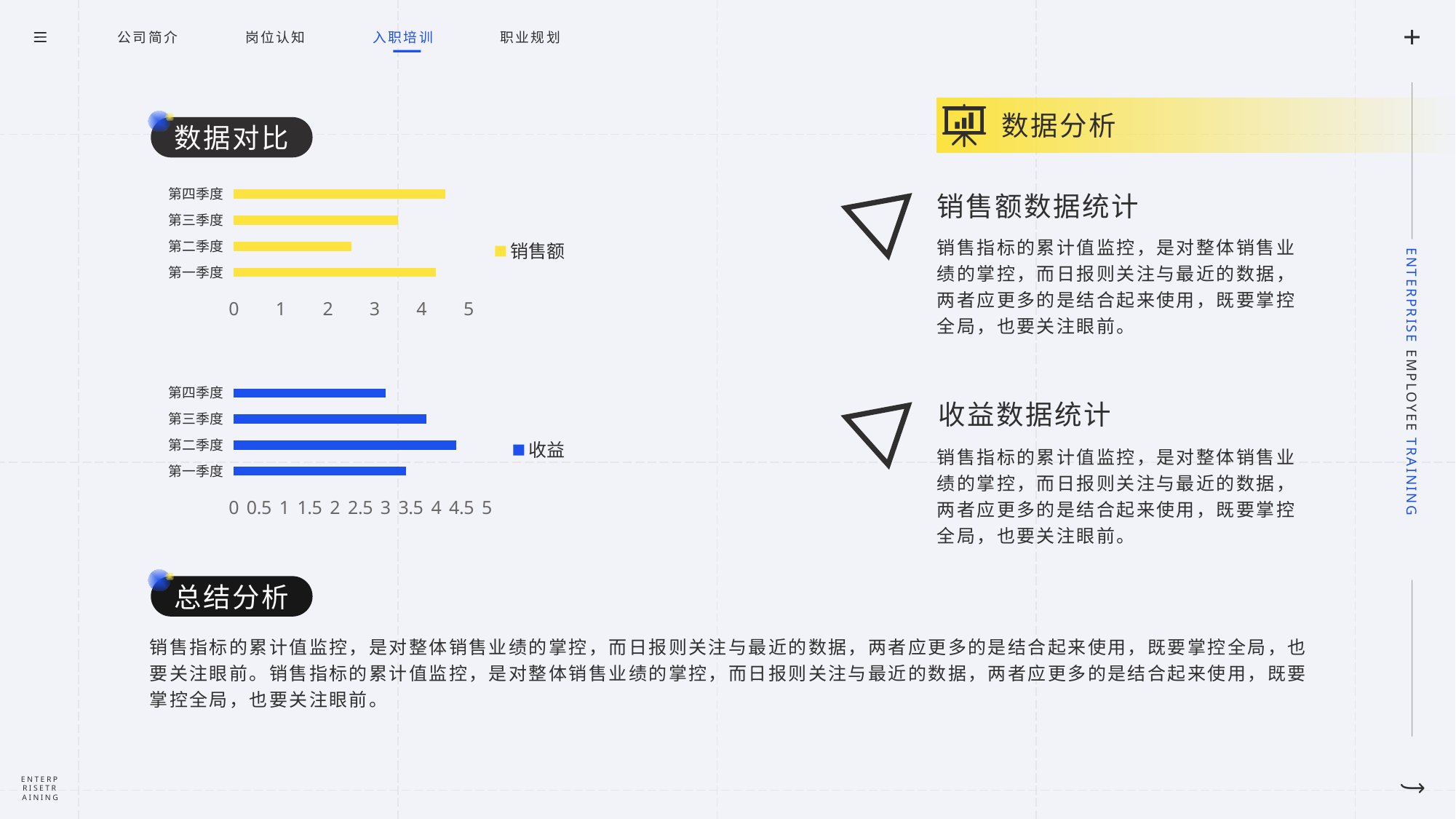
In the bottom chart (收益), which category has the highest value? 第二季度 In the top chart (销售额), is the value for 第四季度 greater or less than 4? greater In the top chart (销售额), how many categories are shown? 4 In the top chart (销售额), is the value for 第二季度 greater or less than 3? less In the bottom chart (收益), which category has the lowest value? 第四季度 In the bottom chart (收益), which is larger, 第三季度 or 第四季度? 第三季度 In the top chart (销售额), which is larger, 第三季度 or 第二季度? 第三季度 What is the legend entry of the top chart? 销售额 In the bottom chart (收益), is the value for 第二季度 greater or less than 4? greater What kind of chart is the top chart with the 销售额 legend? bar chart In the top chart (销售额), which category has the lowest value? 第二季度 In the bottom chart (收益), how many series does the legend list? 1